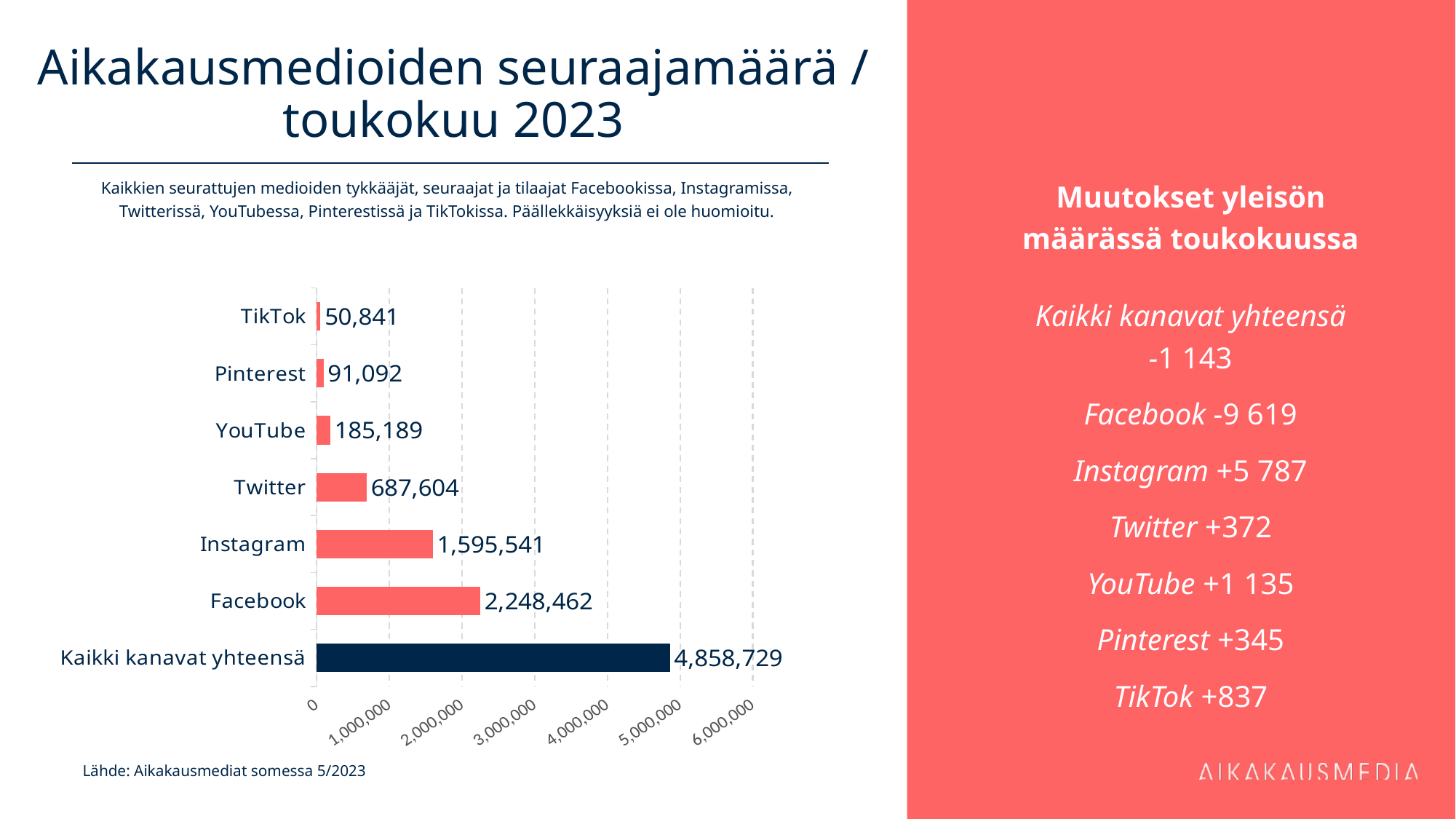
What kind of chart is shown on the slide? bar chart Which individual channel (excluding the total bar) has the highest value? Facebook What is the title of the slide? Aikakausmedioiden seuraajamäärä / toukokuu 2023 What is the value for TikTok? 50,841 What is the value for Facebook? 2,248,462 What is the value for Kaikki kanavat yhteensä? 4,858,729 Which is larger, the value for YouTube or the value for Pinterest? YouTube What is the difference between the values for Facebook and Instagram? 652,921 Which category has the lowest value? TikTok What is the value for Twitter? 687,604 Is the value for Instagram greater or less than 2,000,000? less How many categories are shown in the chart? 7